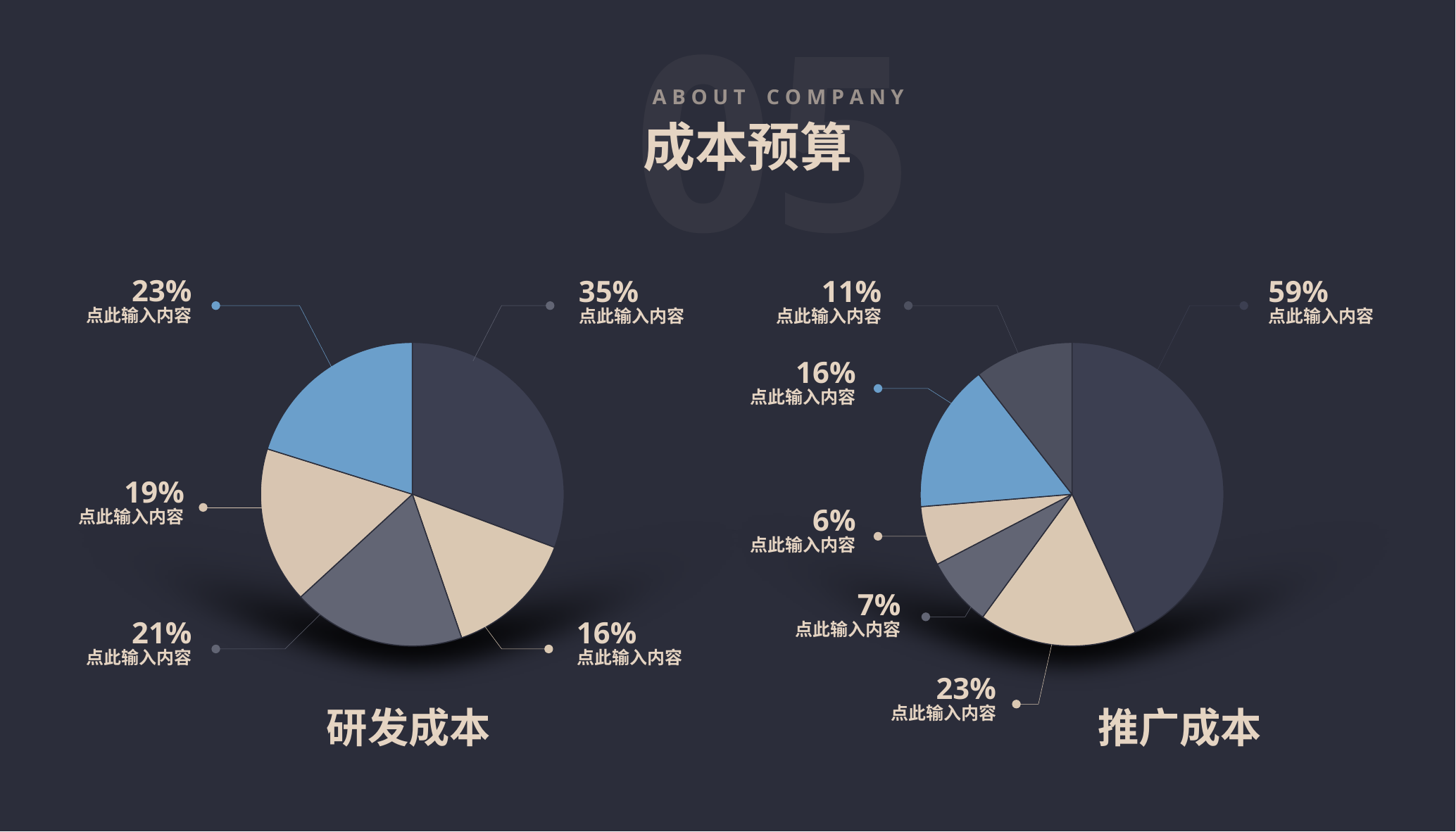
How many slices does the 研发成本 pie chart have? 5 What kind of charts are shown on the slide? Pie charts In the 研发成本 pie chart, what share does the light blue slice represent? 23% In the 推广成本 pie chart, what share does the light blue slice represent? 16% In the 推广成本 pie chart, what is the share of the smallest slice? 6% In the 推广成本 pie chart, what is the share of the largest slice? 59% Which pie chart has the larger biggest slice, 研发成本 or 推广成本? 推广成本 In the 研发成本 pie chart, what is the share of the largest slice? 35% In the 推广成本 pie chart, what is the difference between the 59% slice and the 23% slice? 36% In the 研发成本 pie chart, what is the difference between the largest slice (35%) and the smallest slice (16%)? 19% How many slices does the 推广成本 pie chart have? 6 In the 研发成本 pie chart, what is the share of the smallest slice? 16%